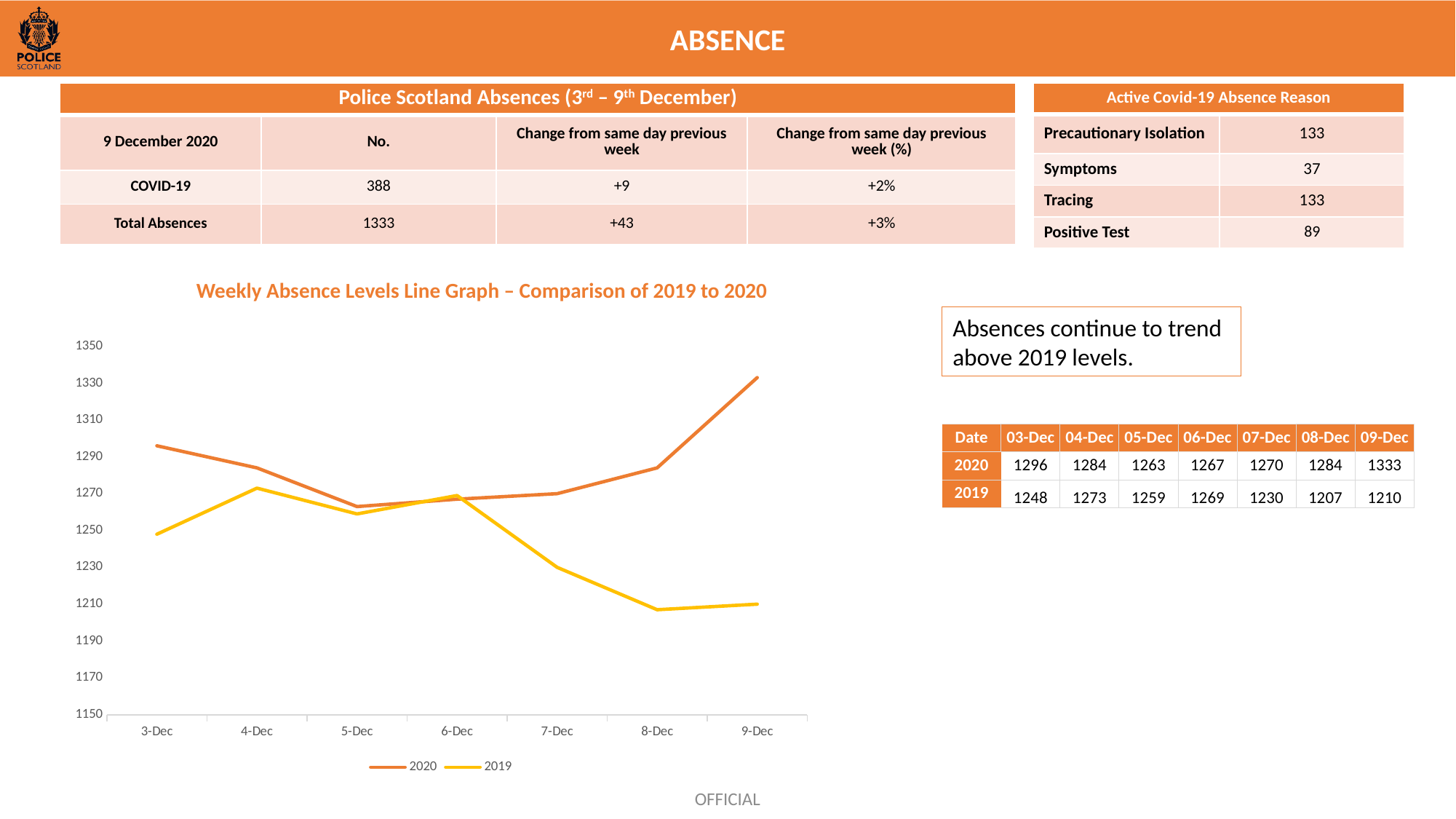
What is the 2020 absence value on 9-Dec in the Weekly Absence Levels chart? 1333 What is the 2019 absence value on 8-Dec in the Weekly Absence Levels chart? 1207 How many dates are plotted along the x axis of the Weekly Absence Levels chart? 7 What is the difference between the 2020 and 2019 values on 9-Dec in the Weekly Absence Levels chart? 123 Which series has the higher value on 3-Dec in the Weekly Absence Levels chart, 2020 or 2019? 2020 What kind of chart is the Weekly Absence Levels chart? line chart Does the 2019 series rise or fall from 6-Dec to 8-Dec in the Weekly Absence Levels chart? fall On which date is the 2019 series lowest in the Weekly Absence Levels chart? 8-Dec Which colour is used for the 2019 series in the Weekly Absence Levels chart? yellow Is the 2019 value on 7-Dec greater or less than 1250 in the Weekly Absence Levels chart? less How many series does the legend of the Weekly Absence Levels chart list? 2 On which date is the 2020 series highest in the Weekly Absence Levels chart? 9-Dec